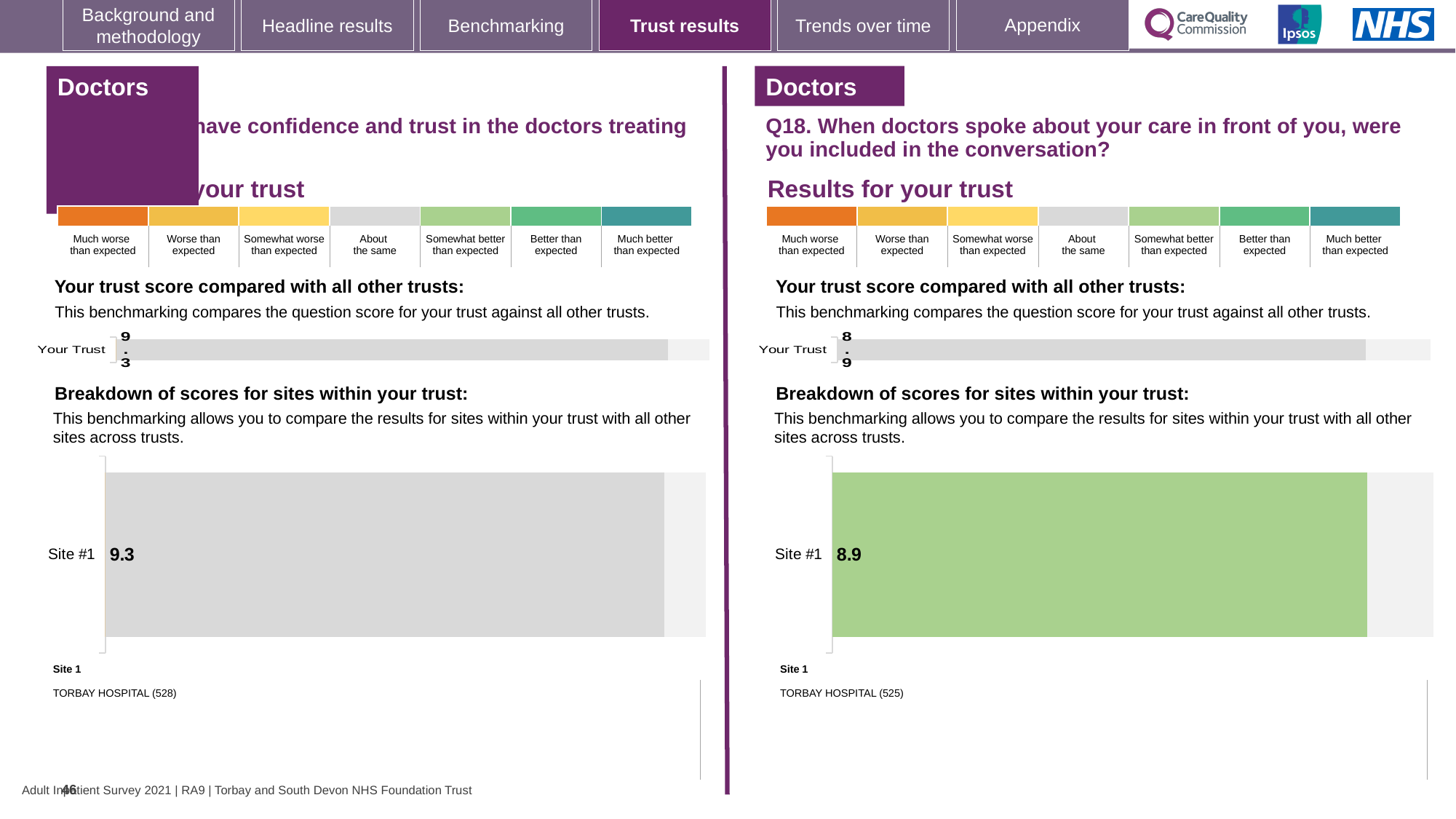
On the left-hand chart, which site name is listed as Site 1? TORBAY HOSPITAL (528) On the right-hand chart for Q18, what is the score shown for Site #1? 8.9 Which is larger: the Site #1 score on the left-hand chart or the Site #1 score on the right-hand chart for Q18? Left-hand chart (9.3) On the right-hand chart for Q18, what is the score shown for Your Trust? 8.9 What type of chart is used to show the Site #1 score on the right-hand chart for Q18? Bar chart On the left-hand chart, what is the score shown for Site #1? 9.3 On the left-hand chart, what is the score shown for Your Trust? 9.3 How many sites are shown in the site breakdown on the left-hand chart? 1 What is the difference between the Site #1 score on the left-hand chart and the Site #1 score on the right-hand chart for Q18? 0.4 On the right-hand chart for Q18, what colour is the Site #1 bar? Green On the right-hand chart for Q18, which site name is listed as Site 1? TORBAY HOSPITAL (525)